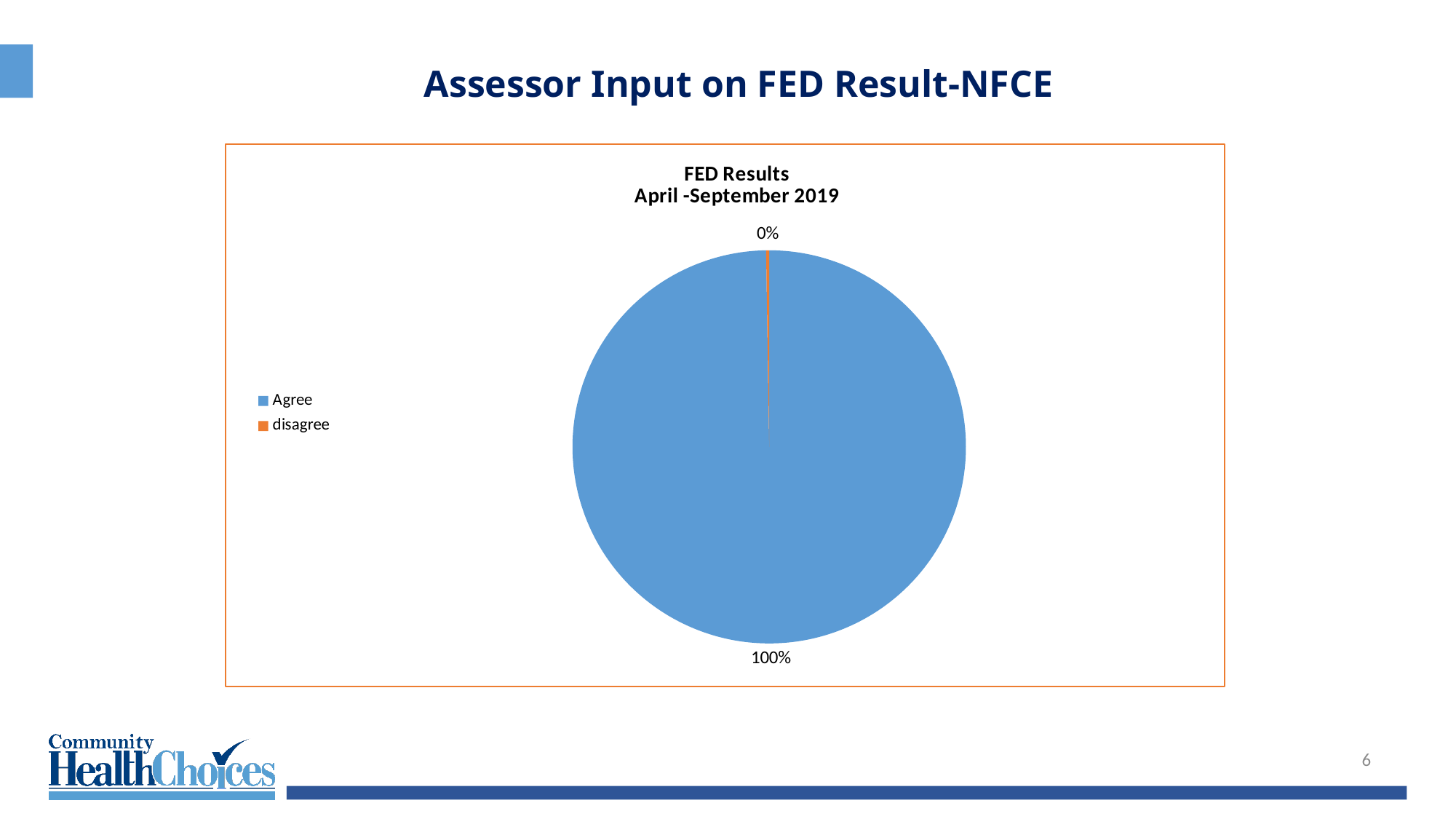
What kind of chart is shown on the slide? pie chart What percentage is shown for Agree? 100% What share of the pie does Agree take up? 100% What is the difference between the Agree and disagree percentages? 100% Which category has the largest share of the pie? Agree Which category has the smallest share of the pie? disagree What is the title of the chart? FED Results April -September 2019 What colour represents Agree in the chart? blue What percentage is shown for disagree? 0% How many categories does the legend list? 2 Which is larger, the share for Agree or the share for disagree? Agree